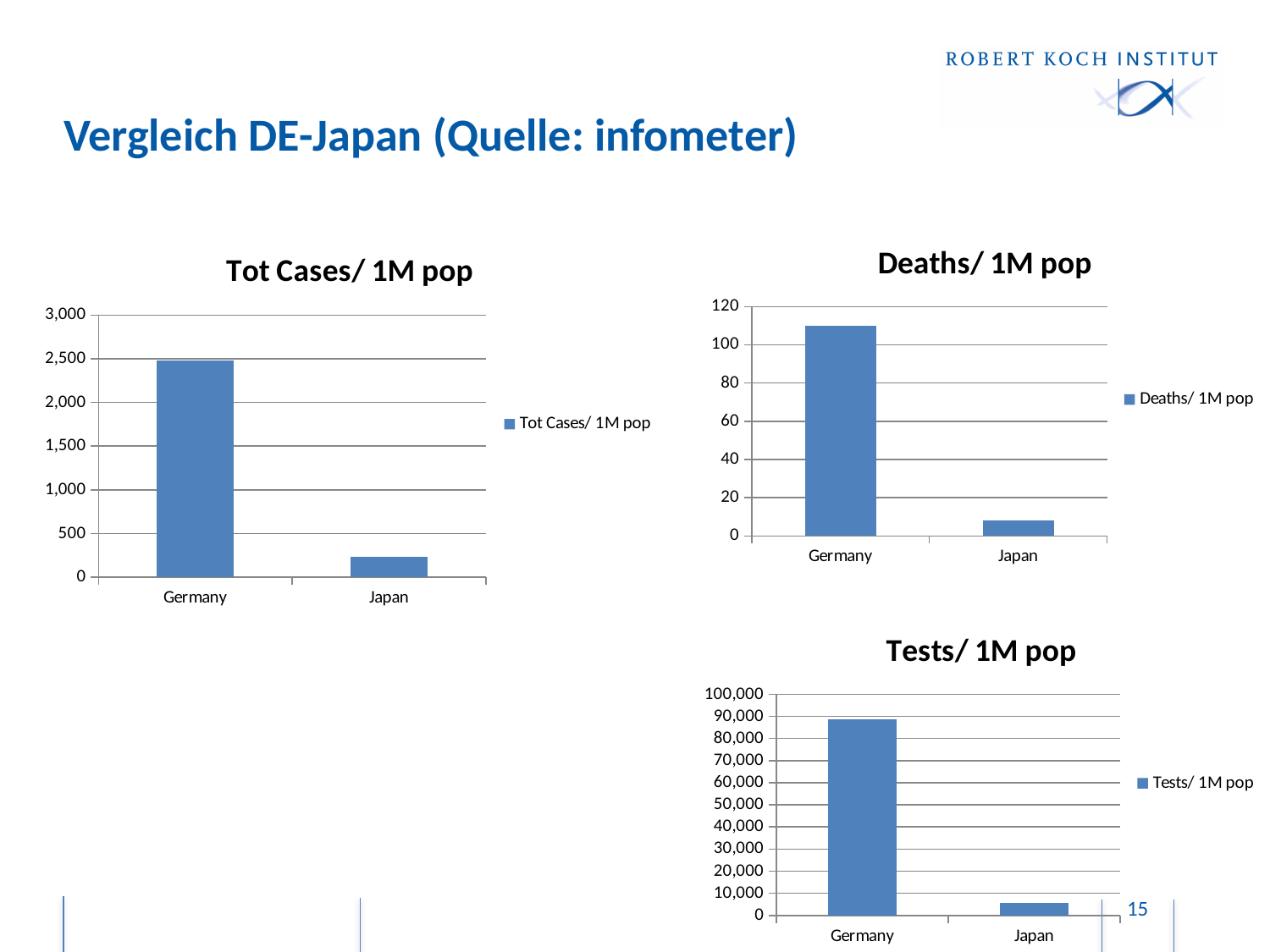
In the 'Tests/ 1M pop' chart, which country has the higher value, Germany or Japan? Germany In the 'Tests/ 1M pop' chart, is the value for Germany greater or less than 80,000? greater In the 'Tot Cases/ 1M pop' chart, is the value for Germany greater or less than 2,000? greater In the 'Deaths/ 1M pop' chart, is the value for Germany greater or less than 100? greater How many categories are shown in the 'Deaths/ 1M pop' chart? 2 In the 'Tot Cases/ 1M pop' chart, which country has the higher value? Germany In the 'Deaths/ 1M pop' chart, which country has the lower value? Japan What kind of chart is the 'Tests/ 1M pop' chart? bar chart How many series does the legend of the 'Tot Cases/ 1M pop' chart list? 1